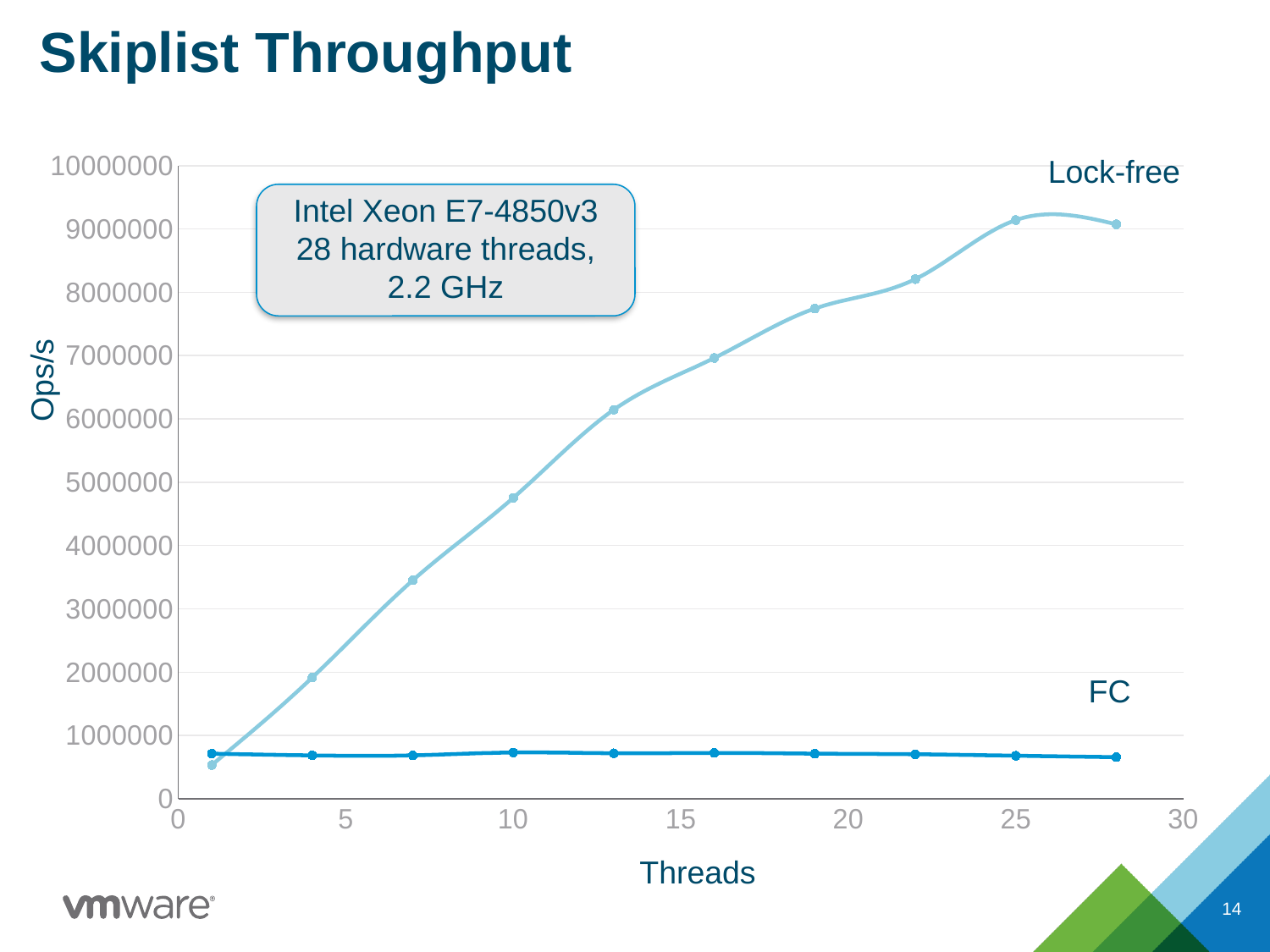
Is the Lock-free value at 28 threads greater or less than 8000000 Ops/s? greater What are the names of the two series plotted on the chart? Lock-free and FC Is the FC value at 16 threads greater or less than 1000000 Ops/s? less How many series are plotted on the chart? 2 How many data points are plotted for the Lock-free series? 10 Is the Lock-free value at 10 threads greater or less than 4000000 Ops/s? greater Which series reaches the higher throughput, Lock-free or FC? Lock-free What is the title of the chart? Skiplist Throughput Does the Lock-free series generally rise or fall as the number of threads increases? rise At 10 threads, which series has the larger Ops/s value, Lock-free or FC? Lock-free At which number of threads is the Lock-free series at its lowest value? 1 What kind of chart is shown on the slide? line chart